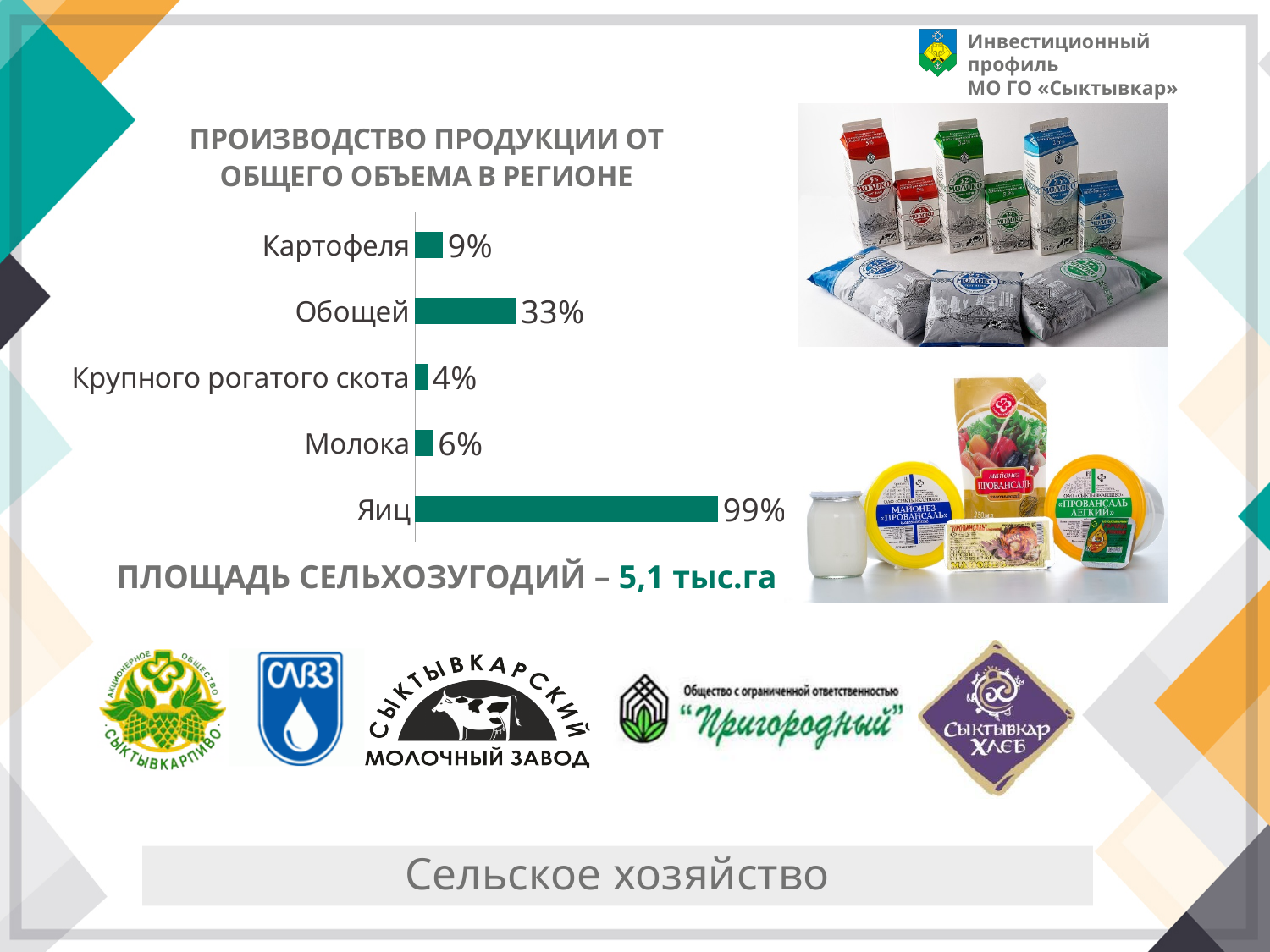
Which category has the highest value? Яиц How many categories are shown in the chart? 5 What is the value for Яиц? 99% Which is larger, the value for Картофеля or the value for Молока? Картофеля What is the value for Обощей? 33% What is the value for Молока? 6% What is the value for Картофеля? 9% What is the value for Крупного рогатого скота? 4% Which category has the lowest value? Крупного рогатого скота What is the difference between the values for Яиц and Обощей? 66% What kind of chart is shown on the slide? Bar chart What is the title of the chart? ПРОИЗВОДСТВО ПРОДУКЦИИ ОТ ОБЩЕГО ОБЪЕМА В РЕГИОНЕ